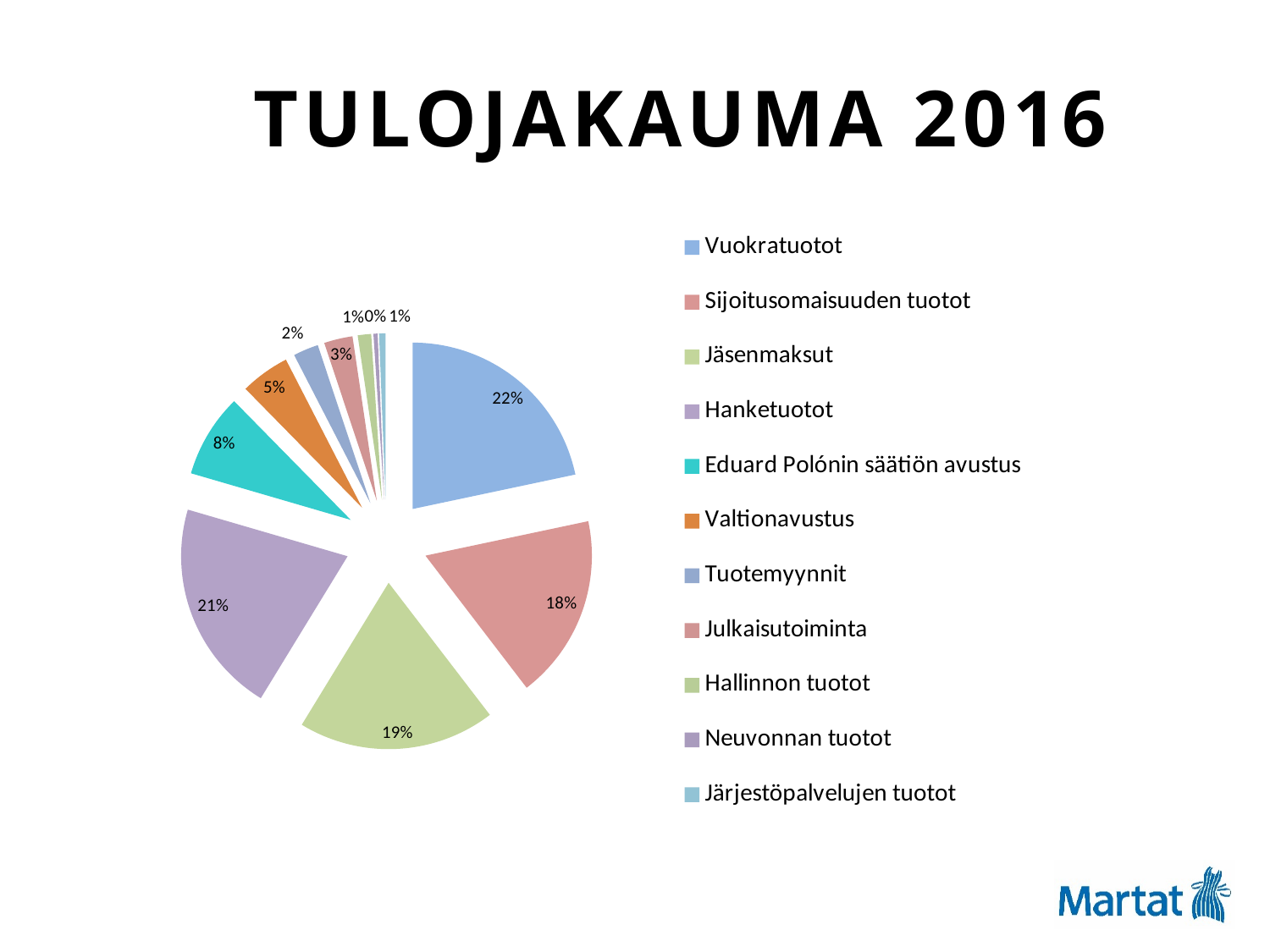
Which category has the largest share of the pie? Vuokratuotot What is the title of the chart? TULOJAKAUMA 2016 What share of the pie is Hanketuotot? 21% What share of the pie is Vuokratuotot? 22% What share of the pie is Valtionavustus? 5% What is the difference between the share for Vuokratuotot and the share for Eduard Polónin säätiön avustus? 14% How many categories does the legend list? 11 Which is larger, the share for Jäsenmaksut or the share for Sijoitusomaisuuden tuotot? Jäsenmaksut What kind of chart is shown on the slide? pie chart